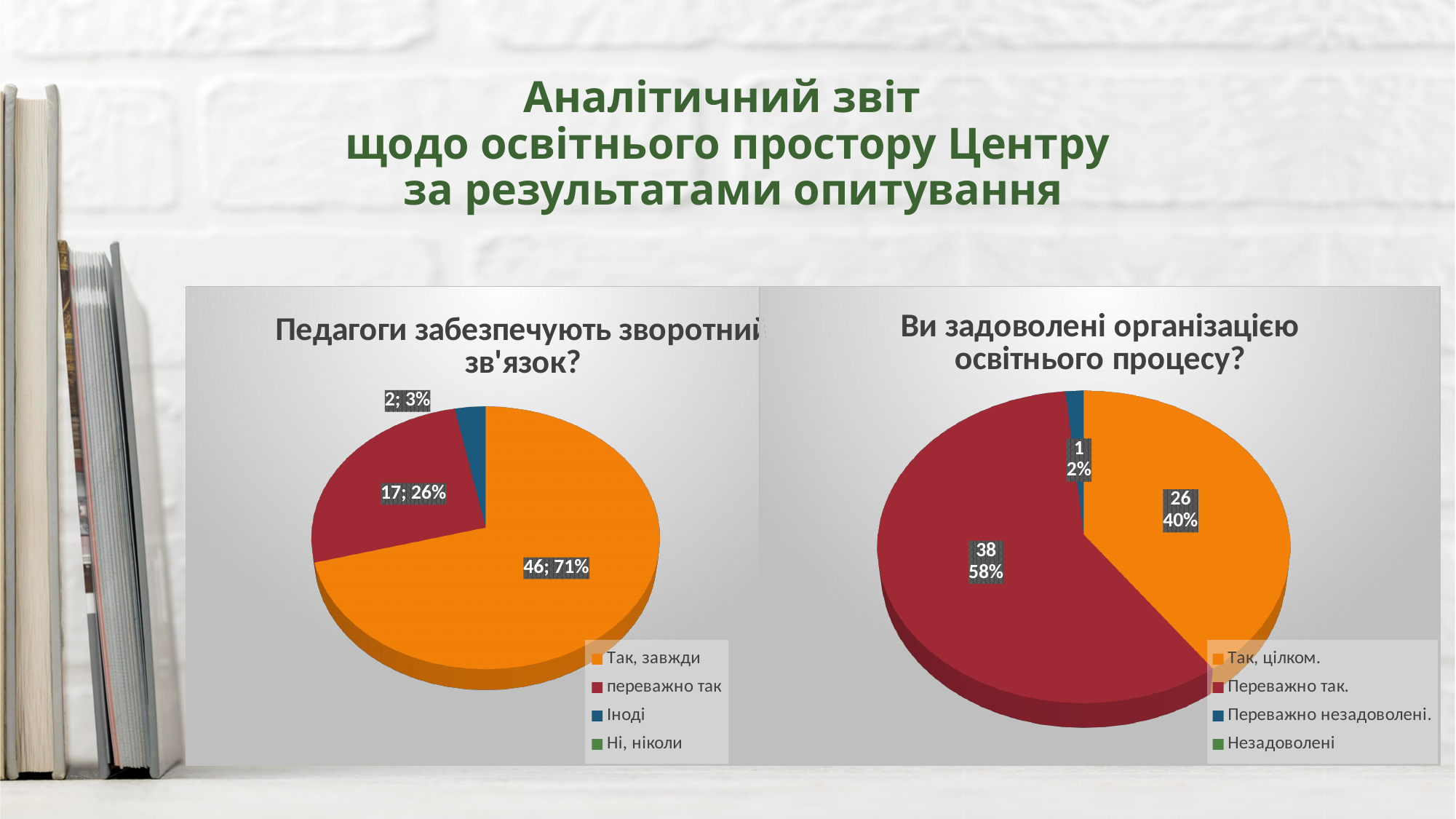
In the left chart 'Педагоги забезпечують зворотний зв'язок?', what is the value for 'Так, завжди'? 46; 71% In the right chart 'Ви задоволені організацією освітнього процесу?', what percentage share does 'Так, цілком.' have? 40% In the right chart 'Ви задоволені організацією освітнього процесу?', which category has the largest slice? Переважно так. In the left chart 'Педагоги забезпечують зворотний зв'язок?', how many entries does the legend list? 4 In the left chart 'Педагоги забезпечують зворотний зв'язок?', what is the difference in count between 'Так, завжди' and 'переважно так'? 29 In the left chart 'Педагоги забезпечують зворотний зв'язок?', what percentage share does 'переважно так' have? 26% In the right chart 'Ви задоволені організацією освітнього процесу?', what is the value for 'Переважно так.'? 38 What type of chart is the right chart 'Ви задоволені організацією освітнього процесу?'? Pie chart In the left chart 'Педагоги забезпечують зворотний зв'язок?', which category has the smallest slice? Іноді In the right chart 'Ви задоволені організацією освітнього процесу?', what colour is the 'Переважно так.' slice? Red In the right chart 'Ви задоволені організацією освітнього процесу?', which is larger: 'Так, цілком.' or 'Переважно незадоволені.'? Так, цілком. In the right chart 'Ви задоволені організацією освітнього процесу?', what is the difference between 'Переважно так.' and 'Так, цілком.'? 12